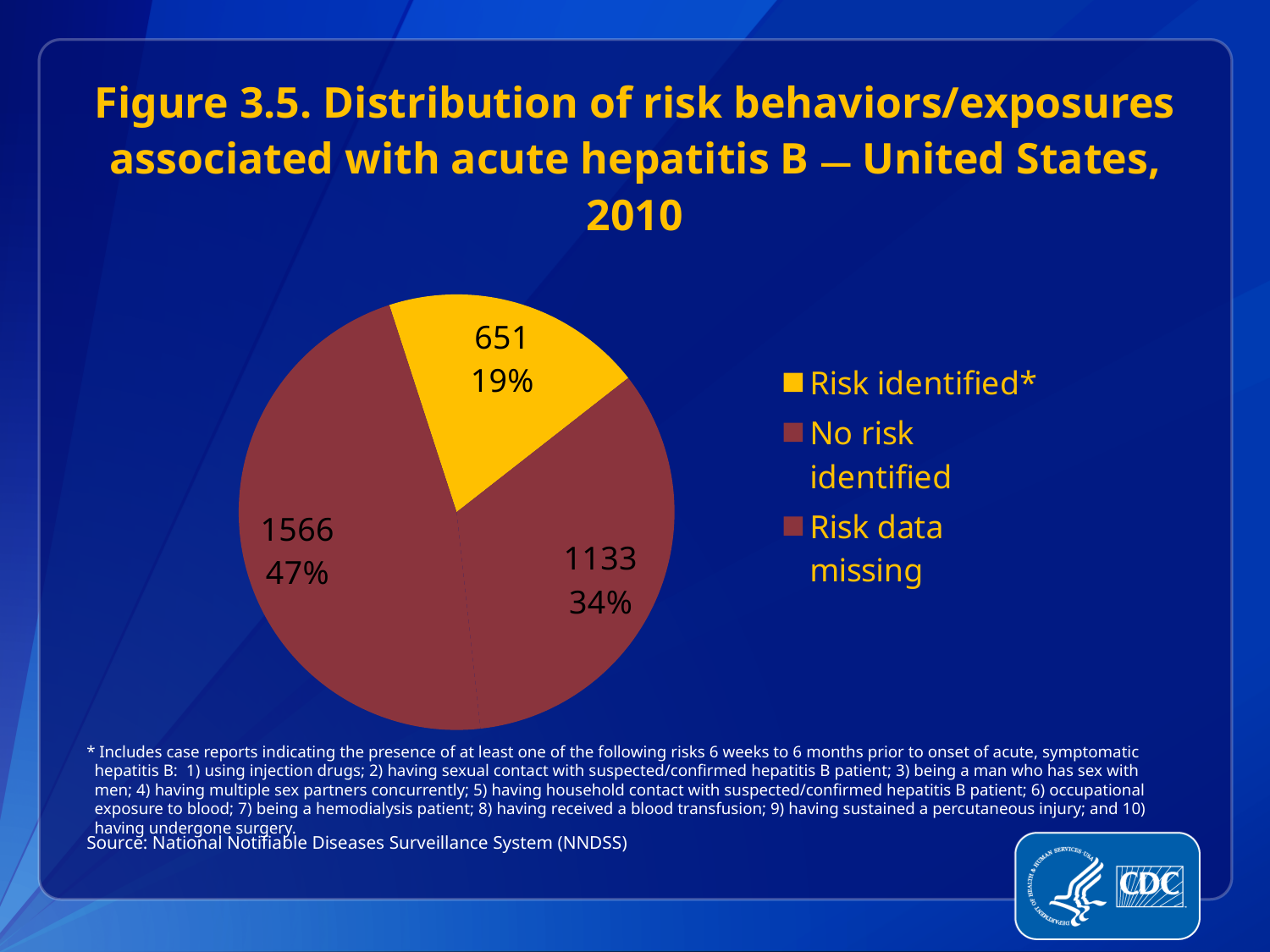
What percentage of the pie does the Risk identified* slice represent? 19% How many slices does the pie chart have? 3 What is the difference between the largest slice value (1566) and the Risk identified* value (651)? 915 How many entries does the legend list? 3 What kind of chart is shown on the slide? pie chart What is the number of cases in the Risk identified* slice? 651 What is the value of the largest slice of the pie? 1566 What colour is the Risk identified* slice in the pie chart? yellow What is the total of the three slice values shown on the pie chart? 3350 Which is larger: the slice labeled 1133 or the slice labeled 651? 1133 What percentage does the largest slice of the pie represent? 47% Which legend category corresponds to the smallest slice of the pie? Risk identified*